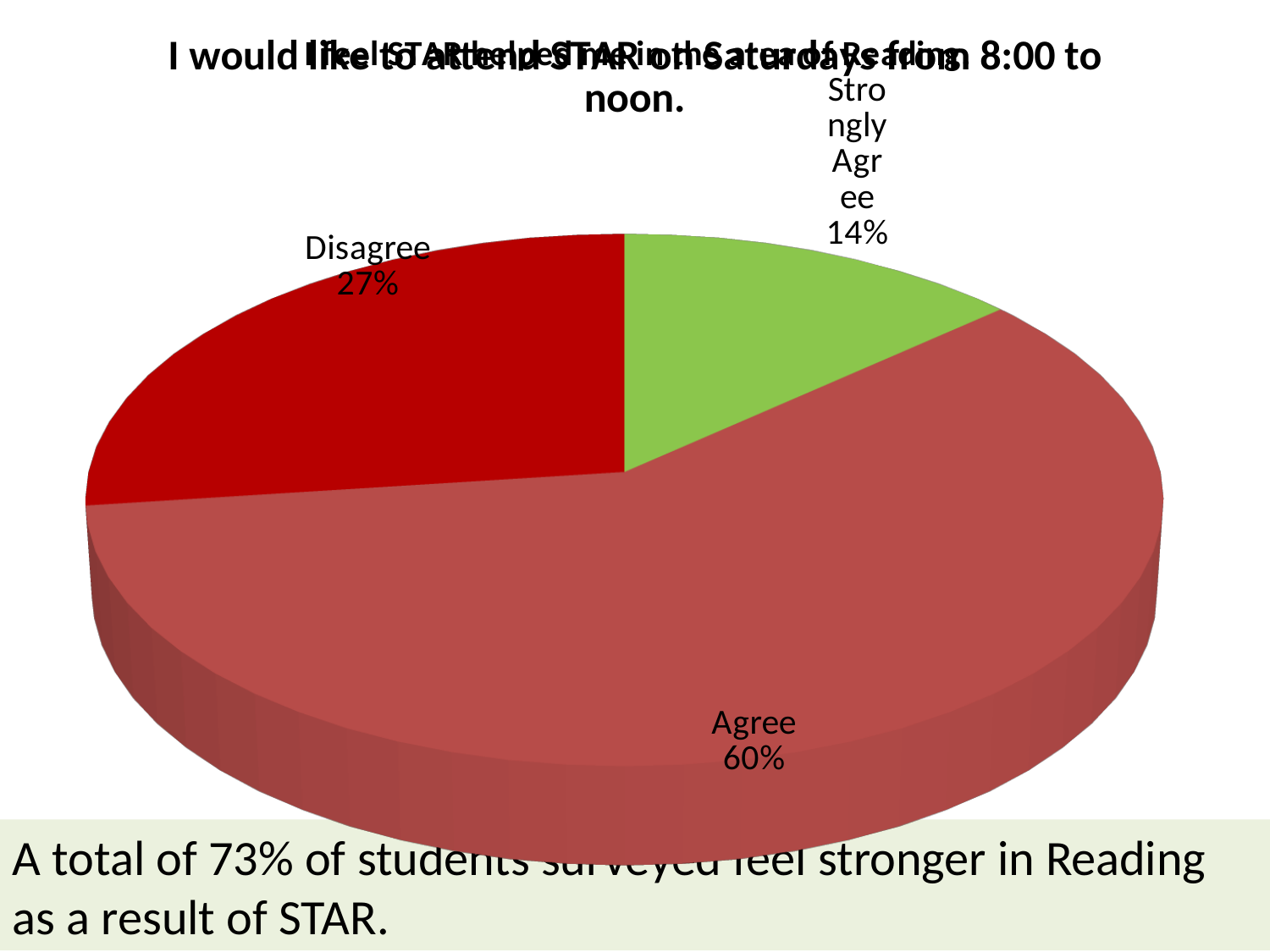
What is the difference in percentage points between the Agree slice and the Disagree slice? 33 Which slice of the pie chart is the largest? Agree What colour is the Strongly Agree slice? green What kind of chart is shown on the slide? pie chart Which slice of the pie chart is the smallest? Strongly Agree What colour is the Disagree slice? dark red Which slice is larger, Disagree or Strongly Agree? Disagree What percentage of the pie is labelled Disagree? 27% How many slices does the pie chart have? 3 What percentage of the pie is labelled Agree? 60% What is the combined share of the Agree and Strongly Agree slices? 74% What percentage of the pie is labelled Strongly Agree? 14%